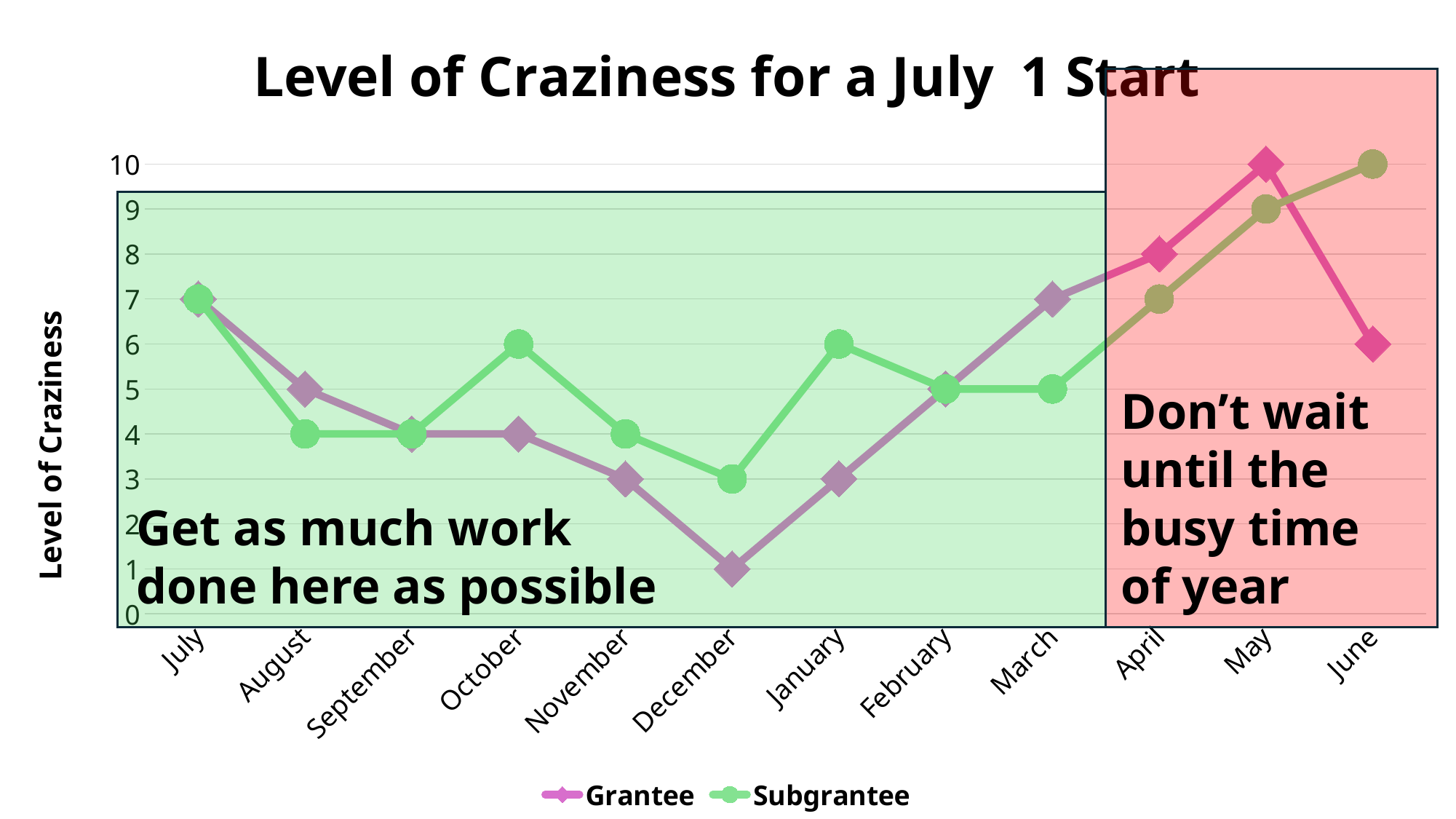
In which month does the Grantee series reach its lowest value? December What is the difference between the Subgrantee and Grantee values in June? 4 In which month does the Subgrantee series reach its highest value? June What is the Subgrantee level of craziness in October? 6 How does the Grantee series change from December to May? It rises How many series does the legend list? 2 What is the title of the chart? Level of Craziness for a July 1 Start In January, which series has the higher value, Grantee or Subgrantee? Subgrantee What is the Grantee level of craziness in December? 1 What is the Grantee level of craziness in May? 10 How many months are plotted along the x axis? 12 What kind of chart is shown on the slide? Line chart